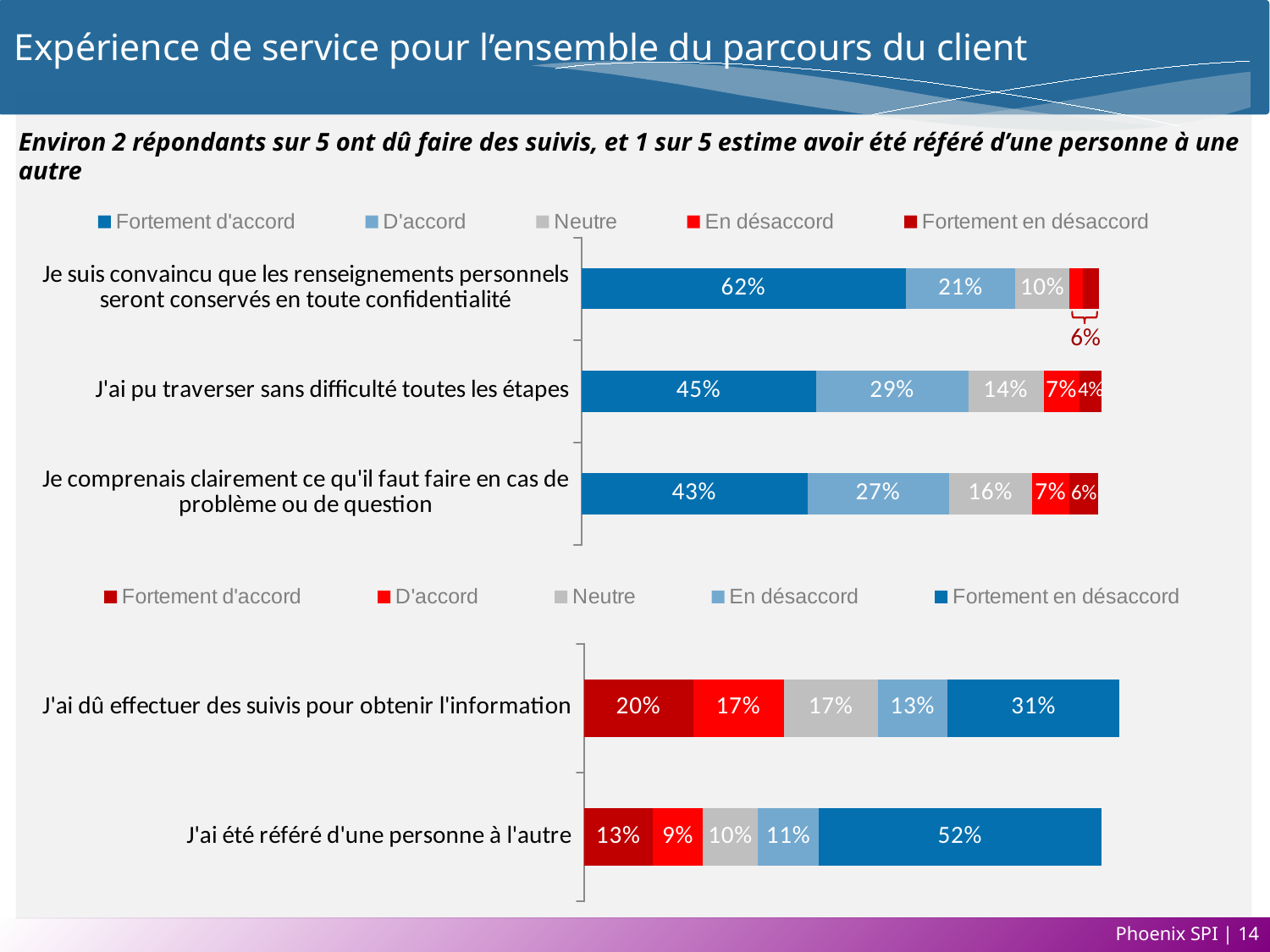
In the top chart, what is the difference between the Fortement d'accord values for "J'ai pu traverser sans difficulté toutes les étapes" and "Je comprenais clairement ce qu'il faut faire en cas de problème ou de question"? 2% In the top chart, what is the Neutre value for "Je comprenais clairement ce qu'il faut faire en cas de problème ou de question"? 16% In the bottom chart, what is the Fortement d'accord value for "J'ai dû effectuer des suivis pour obtenir l'information"? 20% In the bottom chart, what percentage strongly disagree (Fortement en désaccord) with "J'ai été référé d'une personne à l'autre"? 52% In the bottom chart, which statement has the lowest D'accord value? J'ai été référé d'une personne à l'autre How many series does the legend of the top chart list? 5 In the top chart, what percentage of respondents strongly agree (Fortement d'accord) with "Je suis convaincu que les renseignements personnels seront conservés en toute confidentialité"? 62% What type of chart is the top chart? Stacked bar chart How many statements (categories) are shown in the bottom chart? 2 In the top chart, what is the D'accord value for "J'ai pu traverser sans difficulté toutes les étapes"? 29% In the top chart, which statement has the highest Fortement d'accord value? Je suis convaincu que les renseignements personnels seront conservés en toute confidentialité In the bottom chart, which statement has the larger Fortement en désaccord value: "J'ai dû effectuer des suivis pour obtenir l'information" or "J'ai été référé d'une personne à l'autre"? J'ai été référé d'une personne à l'autre